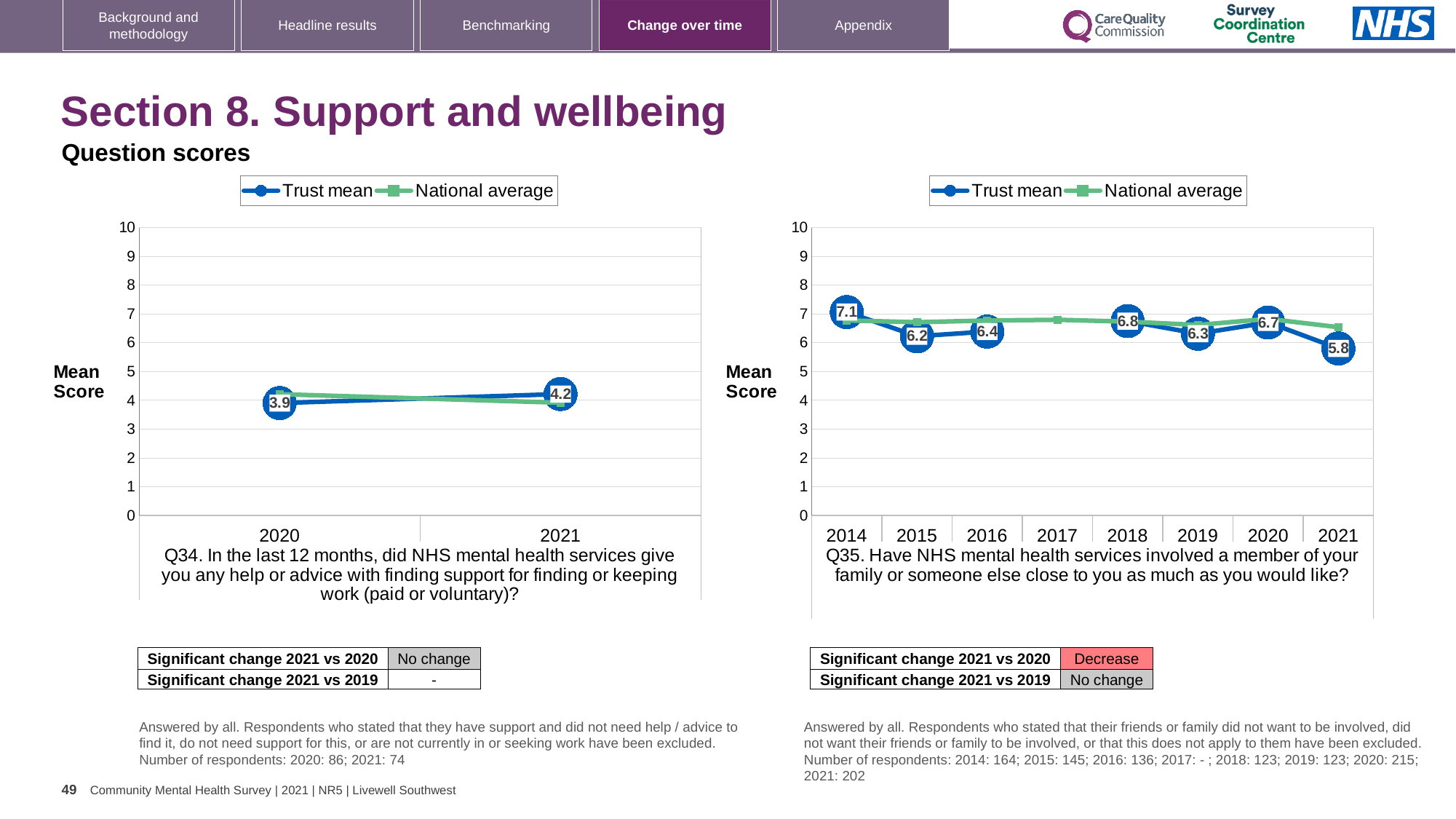
What type of chart is used for the Q34 chart on the left? Line chart In the Q35 chart on the right, what is the Trust mean for 2014? 7.1 In the Q35 chart on the right, which year has the highest Trust mean? 2014 How many years are shown on the x axis of the Q35 chart on the right? 8 In the Q34 chart on the left, what is the Trust mean for 2020? 3.9 In the Q34 chart on the left, by how much did the Trust mean change from 2020 to 2021? 0.3 In the Q34 chart on the left, what is the Trust mean for 2021? 4.2 In the Q35 chart on the right, what is the Trust mean for 2021? 5.8 In the Q35 chart on the right, what is the difference between the Trust mean in 2020 and in 2021? 0.9 In the Q35 chart on the right, is the Trust mean for 2018 or for 2019 higher? 2018 In the Q35 chart on the right, which year has the lowest Trust mean? 2021 In the Q35 chart on the right, is the National average for 2021 greater or less than 6? greater